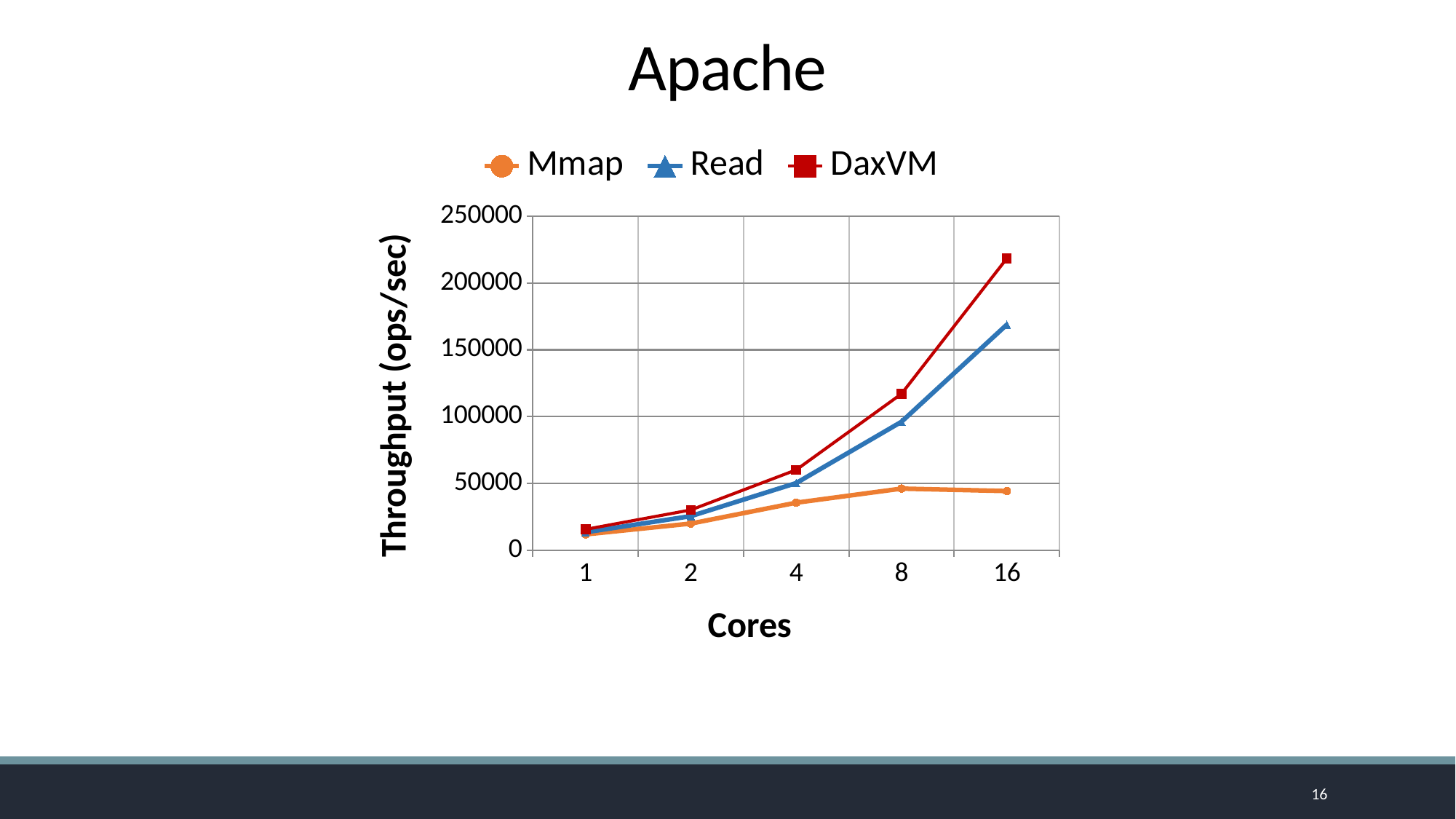
How many core counts are plotted along the x axis? 5 Which series has the lowest throughput at 16 cores? Mmap Which series has the highest throughput at 16 cores? DaxVM Is the DaxVM throughput at 16 cores greater or less than 200000? greater What is the title of the chart? Apache What kind of chart is shown on the slide? line chart Is the Read throughput at 16 cores greater or less than 150000? greater Is the Mmap throughput at 16 cores greater or less than 50000? less At 16 cores, which has higher throughput, Read or Mmap? Read How many series does the legend list? 3 Does the DaxVM throughput rise or fall as the number of cores increases? rise